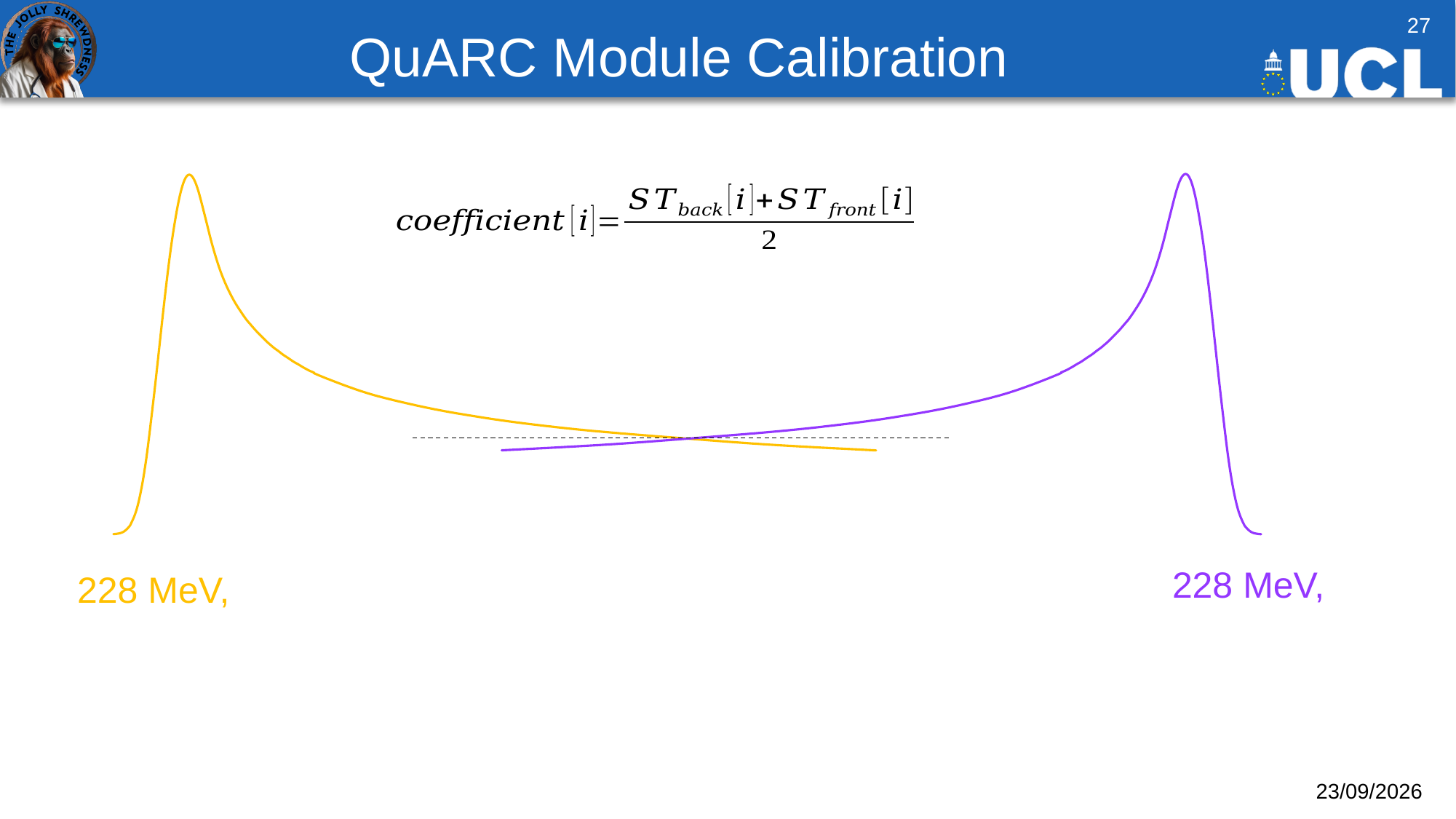
How many curves are plotted on the slide? 2 Moving from left to right after its peak, does the yellow curve rise or fall? fall What colour is the curve whose peak is on the left side of the slide? yellow What is the title of the slide containing the curves? QuARC Module Calibration What energy label is written beneath the purple curve? 228 MeV What kind of chart is shown on the slide? line chart Moving from left to right towards its peak, does the purple curve rise or fall? rise